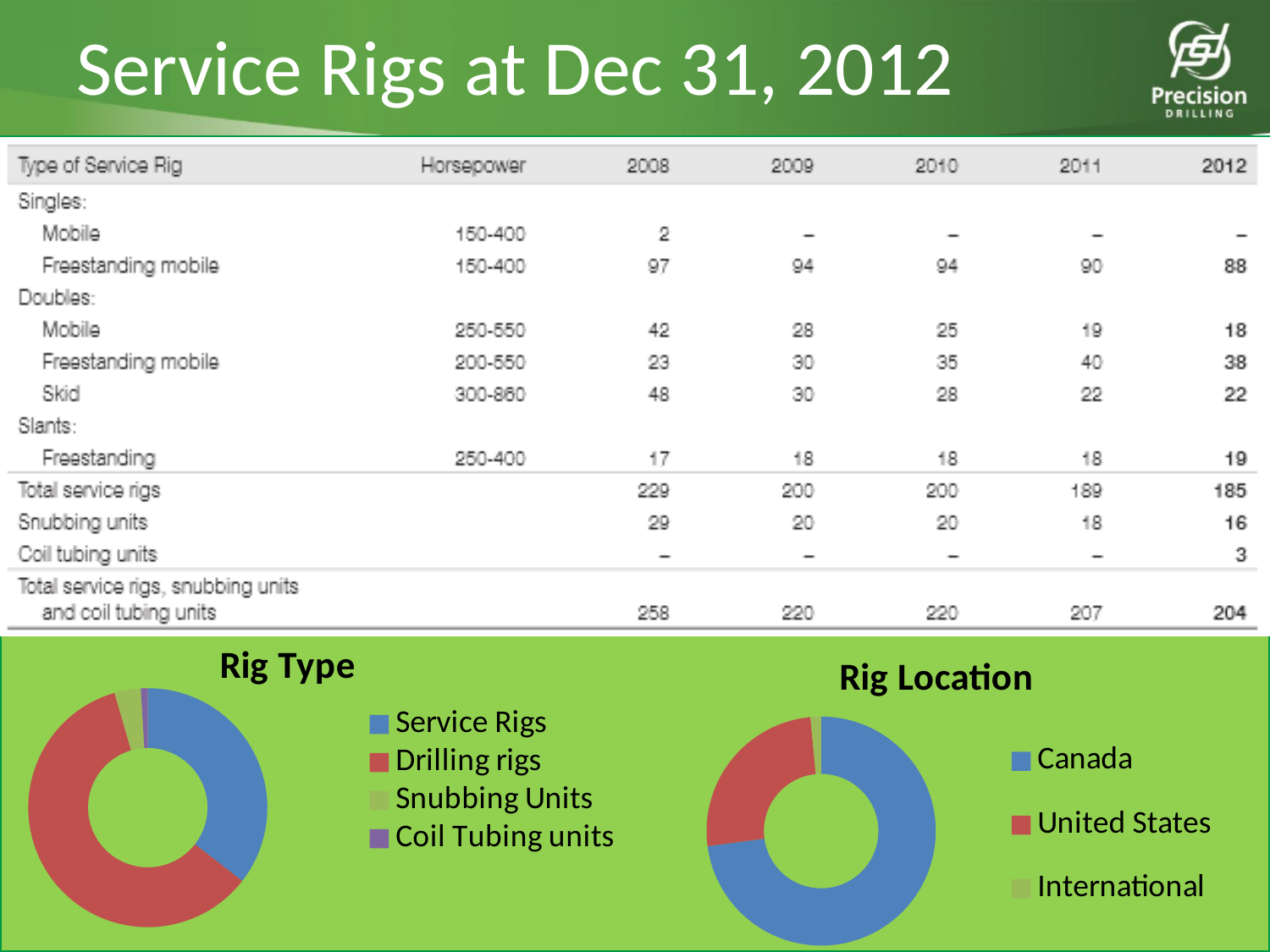
In the Rig Type chart, which category has the smallest share? Coil Tubing units In the Rig Type chart, which is larger, Drilling rigs or Coil Tubing units? Drilling rigs In the Rig Location chart, which is larger, Canada or United States? Canada What is the title of the chart on the right side of the slide? Rig Location What colour represents Drilling rigs in the Rig Type chart? red How many categories does the legend of the Rig Location chart list? 3 In the Rig Type chart, which is larger, Service Rigs or Snubbing Units? Service Rigs What kind of chart is the Rig Location chart? doughnut chart What kind of chart is the Rig Type chart? doughnut chart In the Rig Location chart, which category has the largest share? Canada How many categories does the legend of the Rig Type chart list? 4